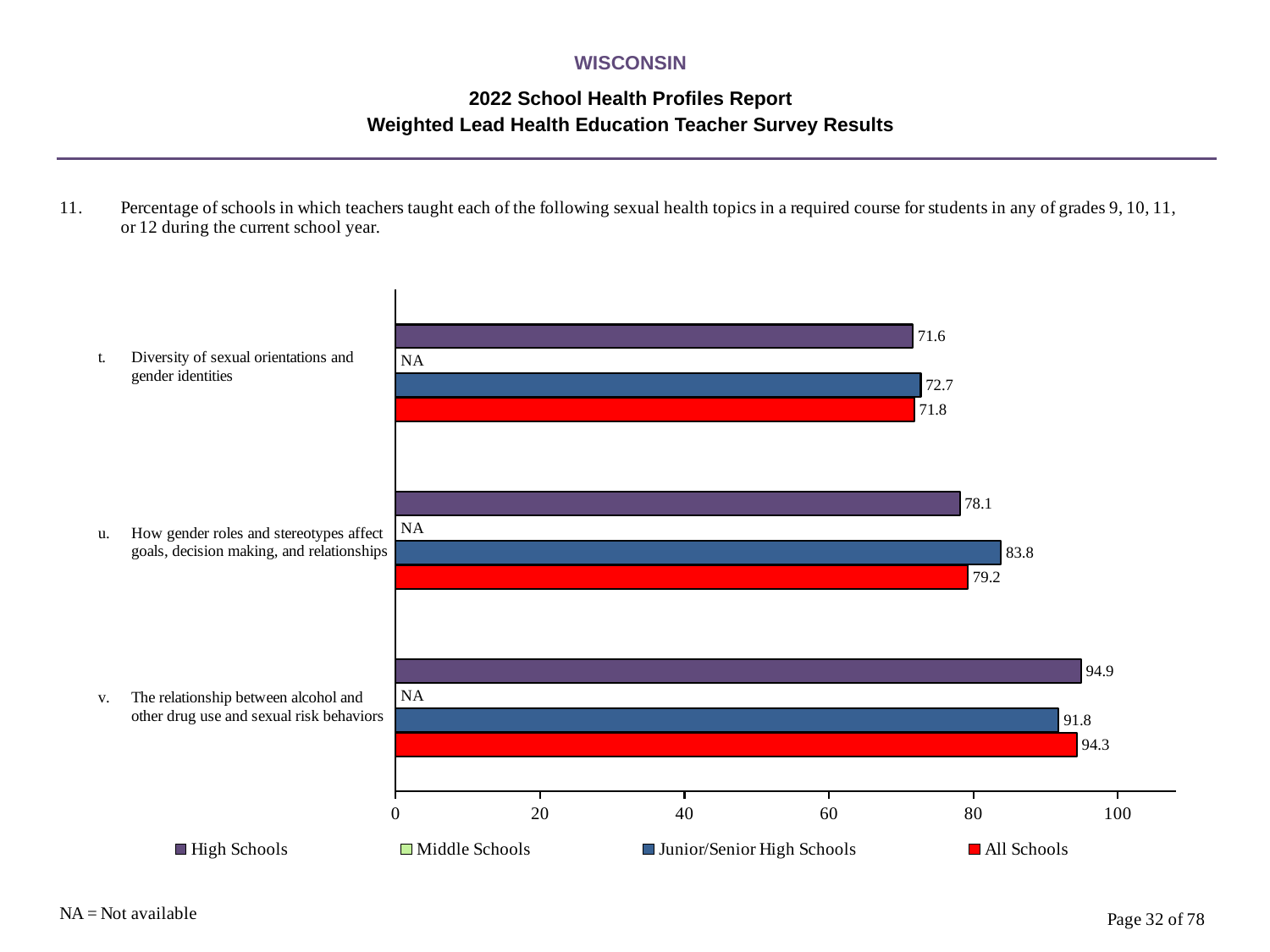
Is the All Schools value for topic u, how gender roles and stereotypes affect goals, decision making, and relationships, greater or less than 80? less How many series does the legend list? 4 What is the value for All Schools for topic v, the relationship between alcohol and other drug use and sexual risk behaviors? 94.3 What is the value for High Schools for topic t, diversity of sexual orientations and gender identities? 71.6 What is shown for Middle Schools for topic t, diversity of sexual orientations and gender identities? NA Which topic has the highest value for High Schools? The relationship between alcohol and other drug use and sexual risk behaviors What is the difference between the Junior/Senior High Schools value and the High Schools value for topic u, how gender roles and stereotypes affect goals, decision making, and relationships? 5.7 What is the value for Junior/Senior High Schools for topic u, how gender roles and stereotypes affect goals, decision making, and relationships? 83.8 What kind of chart is shown on the slide? Bar chart Which topic has the lowest value for All Schools? Diversity of sexual orientations and gender identities For topic v, the relationship between alcohol and other drug use and sexual risk behaviors, which is larger: the High Schools value or the Junior/Senior High Schools value? High Schools How many topics are shown on the chart? 3